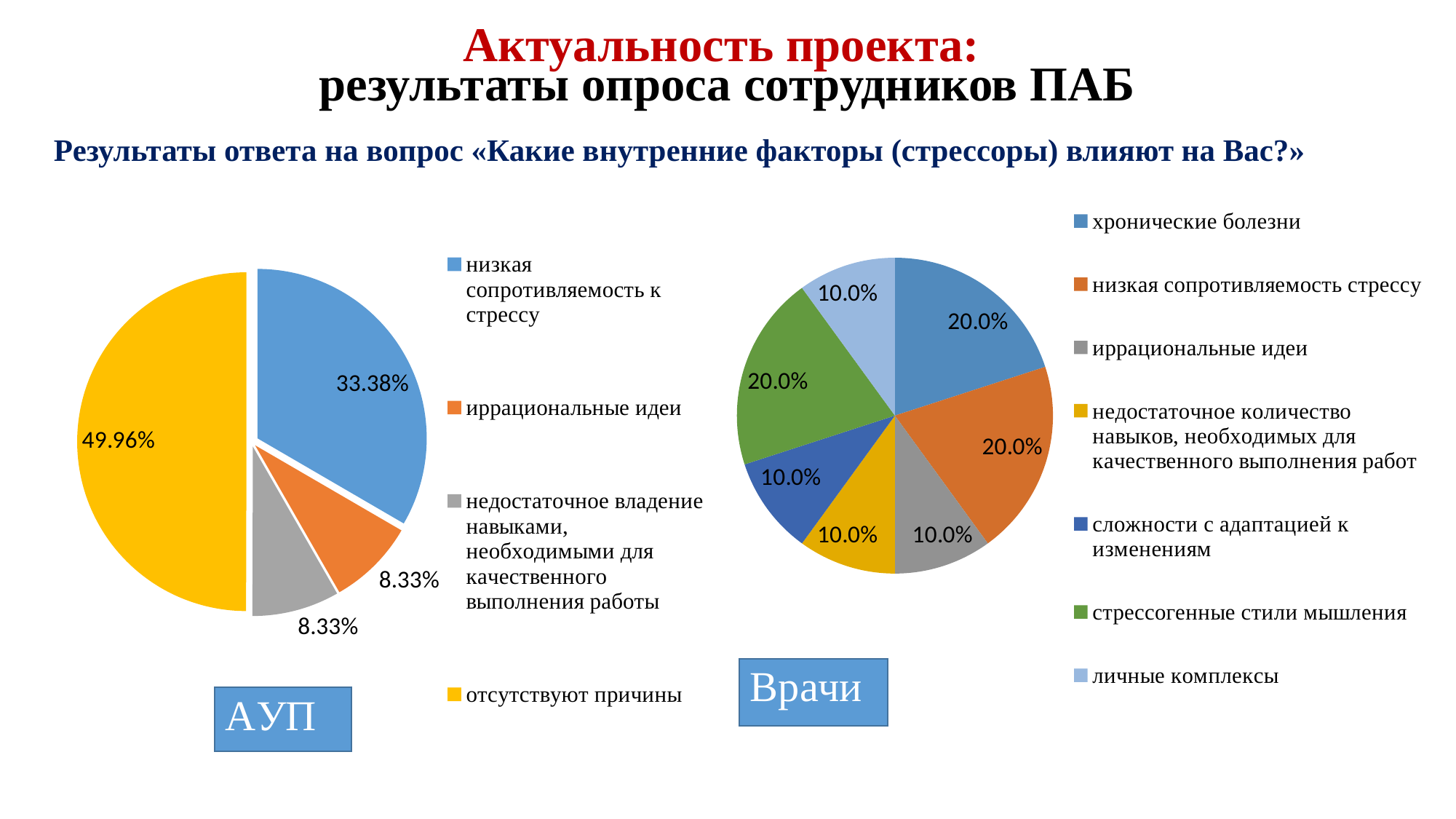
What type of chart is used for the Врачи data? pie chart In the АУП pie chart, what share is shown for «отсутствуют причины»? 49.96% In the Врачи pie chart, what share is shown for «хронические болезни»? 20.0% In the Врачи pie chart, what share is shown for «личные комплексы»? 10.0% In the АУП pie chart, what share is shown for «иррациональные идеи»? 8.33% In the АУП pie chart, what share is shown for «низкая сопротивляемость к стрессу»? 33.38% In the Врачи pie chart, what share is shown for «стрессогенные стили мышления»? 20.0% In the АУП pie chart, which category has the largest slice? отсутствуют причины How many categories does the legend of the Врачи pie chart list? 7 In the Врачи pie chart, which is larger: the share for «низкая сопротивляемость стрессу» or the share for «иррациональные идеи»? низкая сопротивляемость стрессу How many categories does the legend of the АУП pie chart list? 4 In the АУП pie chart, what is the difference between the shares for «отсутствуют причины» and «низкая сопротивляемость к стрессу»? 16.58%